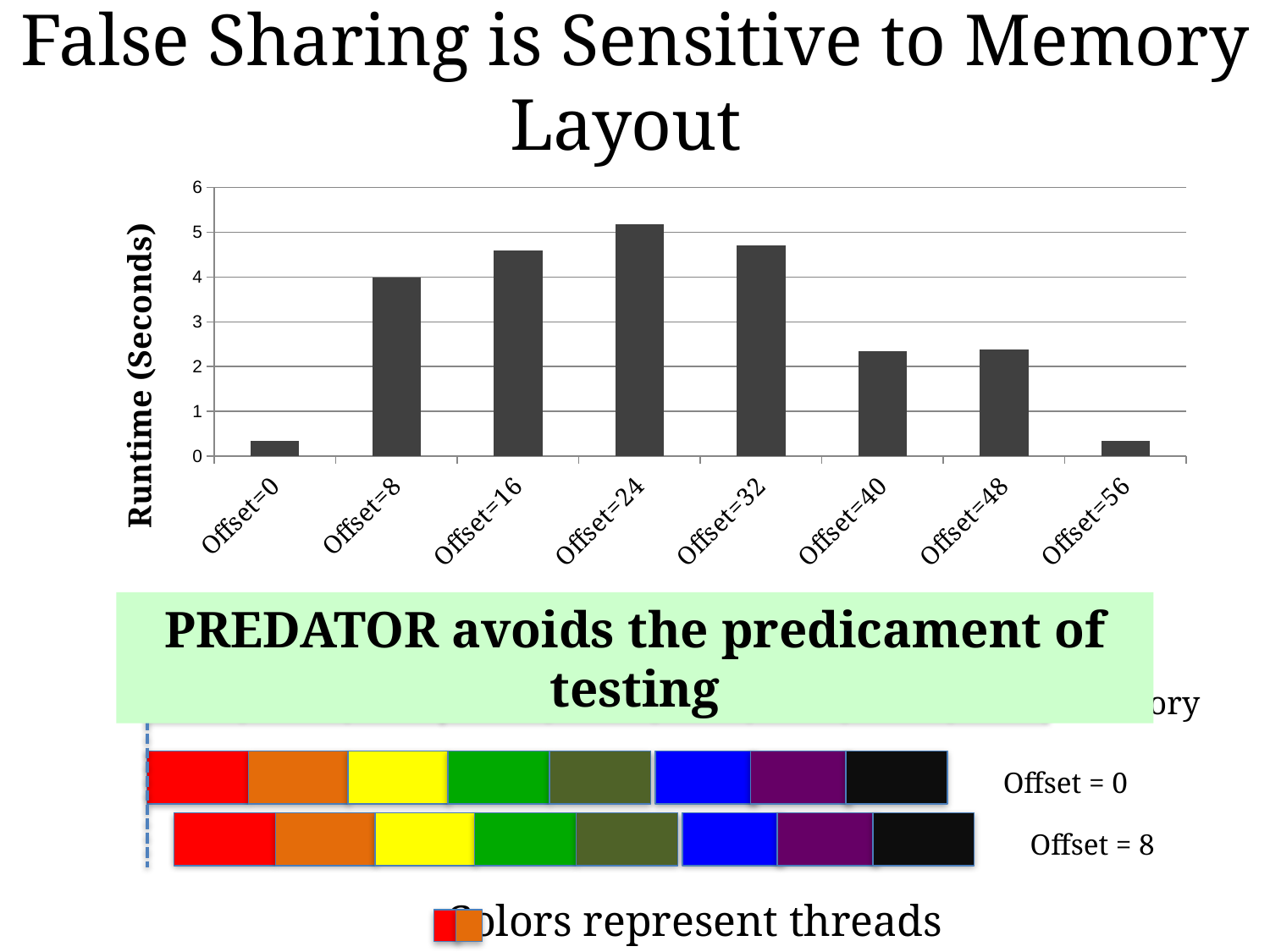
What is the label on the vertical axis of the chart? Runtime (Seconds) Is the runtime for Offset=40 greater or less than 3 seconds? less Is the runtime for Offset=56 greater or less than 1 second? less Which has the larger runtime, Offset=24 or Offset=32? Offset=24 Do the runtimes rise or fall from Offset=0 to Offset=24? rise Is the runtime for Offset=24 greater or less than 4 seconds? greater What kind of chart is shown on the slide? bar chart Which offset has the highest runtime in the chart? Offset=24 How many offset categories are plotted on the x axis of the chart? 8 Which has the larger runtime, Offset=16 or Offset=8? Offset=16